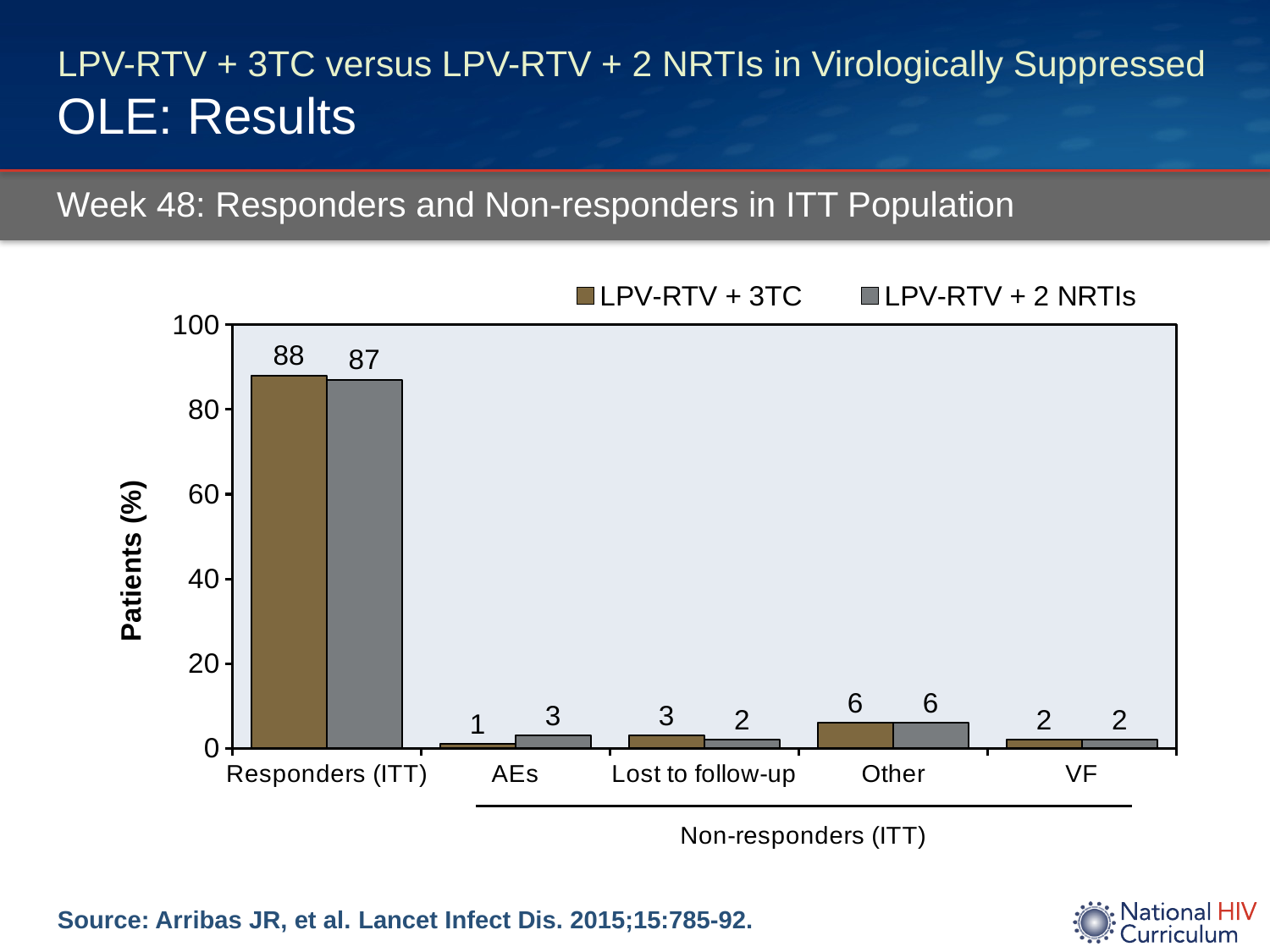
What is the difference between the LPV-RTV + 3TC and LPV-RTV + 2 NRTIs values in the AEs category? 2 Which category has the highest value for LPV-RTV + 3TC? Responders (ITT) What kind of chart is shown on the slide? Bar chart What is the value for LPV-RTV + 2 NRTIs in the AEs category? 3 What is the value for LPV-RTV + 3TC in the Responders (ITT) category? 88 What is the label of the y axis? Patients (%) In the Lost to follow-up category, which series has the larger value, LPV-RTV + 3TC or LPV-RTV + 2 NRTIs? LPV-RTV + 3TC How many categories are shown on the x axis? 5 How many series does the legend list? 2 What is the value for LPV-RTV + 2 NRTIs in the Responders (ITT) category? 87 What is the value for LPV-RTV + 3TC in the Lost to follow-up category? 3 Which category has the lowest value for LPV-RTV + 3TC? AEs